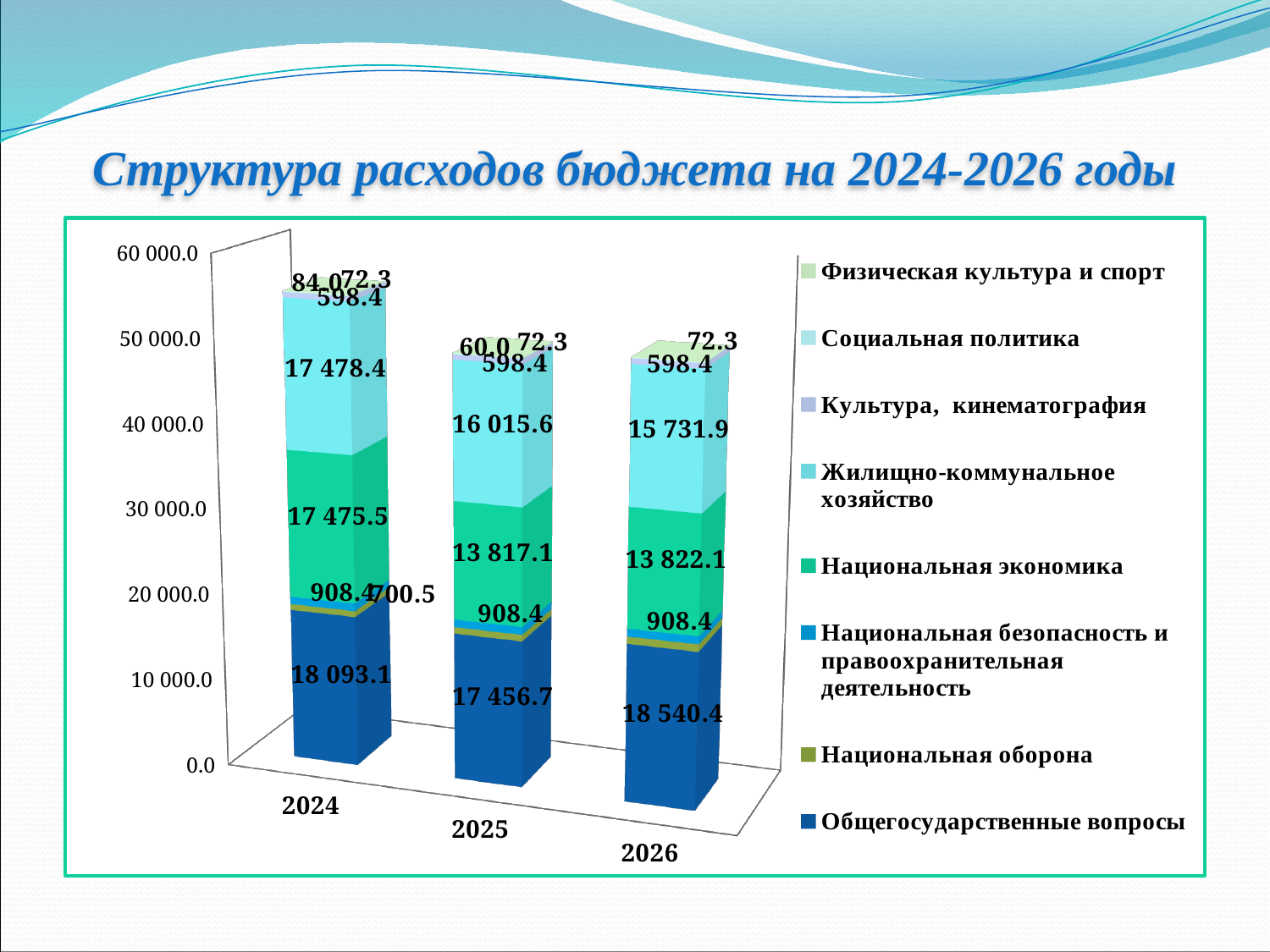
In which year is the value for Общегосударственные вопросы the highest? 2026 How many years (categories) are shown on the x axis of the chart? 3 What is the value for Общегосударственные вопросы in 2026? 18 540.4 What is the value for Национальная безопасность и правоохранительная деятельность in 2025? 908.4 How many series does the chart legend list? 8 Which year has the larger value for Национальная экономика, 2024 or 2025? 2024 What kind of chart is shown on the slide? stacked bar chart What is the title of the slide? Структура расходов бюджета на 2024-2026 годы What is the value for Национальная экономика in 2025? 13 817.1 Do the values for Жилищно-коммунальное хозяйство rise or fall from 2024 to 2026? fall What is the difference between the Жилищно-коммунальное хозяйство values for 2024 and 2026? 1 746.5 What is the value for Жилищно-коммунальное хозяйство in 2024? 17 478.4